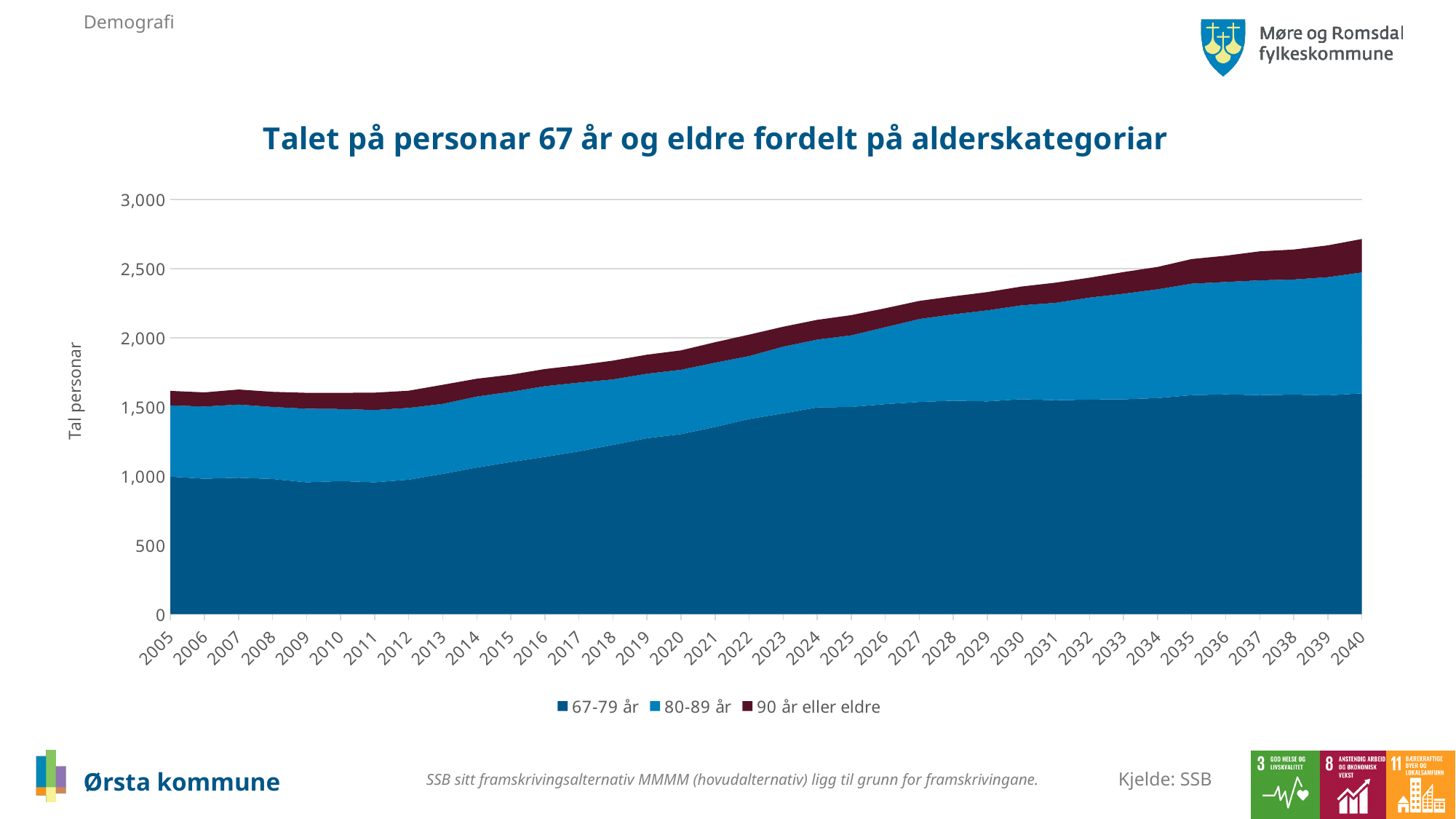
Is the value for 67-79 år in 2040 greater or less than 1,500? greater How many series does the legend list? 3 Does the total number of persons 67 years and older rise or fall from 2005 to 2040? Rise What kind of chart is shown on the slide? Stacked area chart Is the total value for 2020 greater or less than 2,000? less Is the value for 67-79 år in 2020 greater or less than 1,500? less What is the title of the chart? Talet på personar 67 år og eldre fordelt på alderskategoriar How many years are shown along the x axis? 36 What is the label on the y axis? Tal personar Which age category has the smallest value in 2040? 90 år eller eldre Which age category has the largest value in 2040? 67-79 år